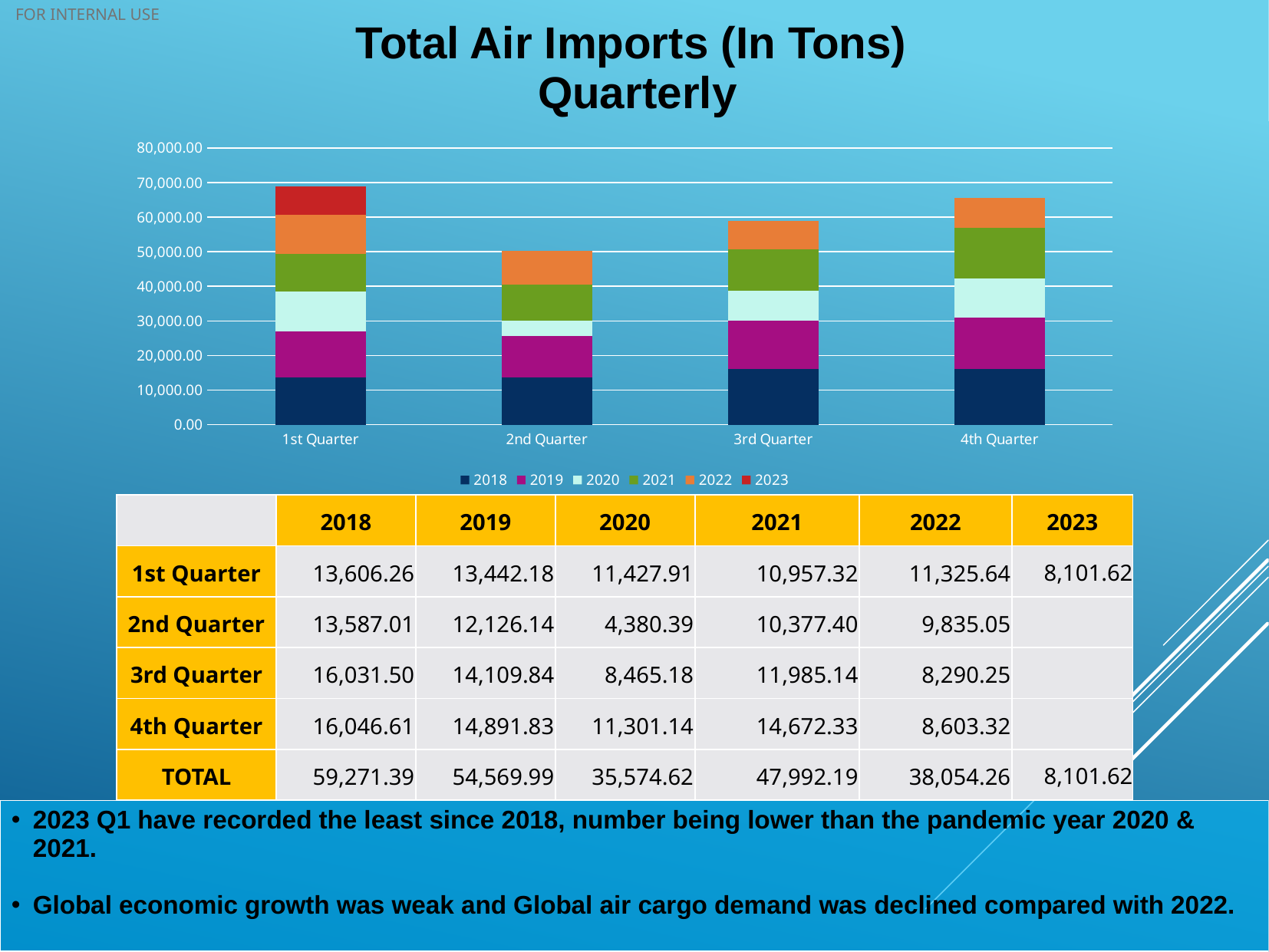
Is the stacked total for the 1st Quarter greater or less than 60,000.00? greater What is the value for 2018 in the 1st Quarter? 13,606.26 Which is larger in the 3rd Quarter, the value for 2021 or the value for 2022? 2021 What is the value for 2020 in the 2nd Quarter? 4,380.39 Which quarter has the lowest stacked total across all years? 2nd Quarter What is the total of the stacked bar for the 2nd Quarter? 50,305.99 How many series does the chart legend list? 6 What is the value for 2023 in the 1st Quarter? 8,101.62 What is the difference between the 2018 values for the 4th Quarter and the 1st Quarter? 2,440.35 What kind of chart is shown on the slide? Stacked bar chart How many quarters are plotted along the x axis? 4 Which quarter has the lowest value for 2020? 2nd Quarter